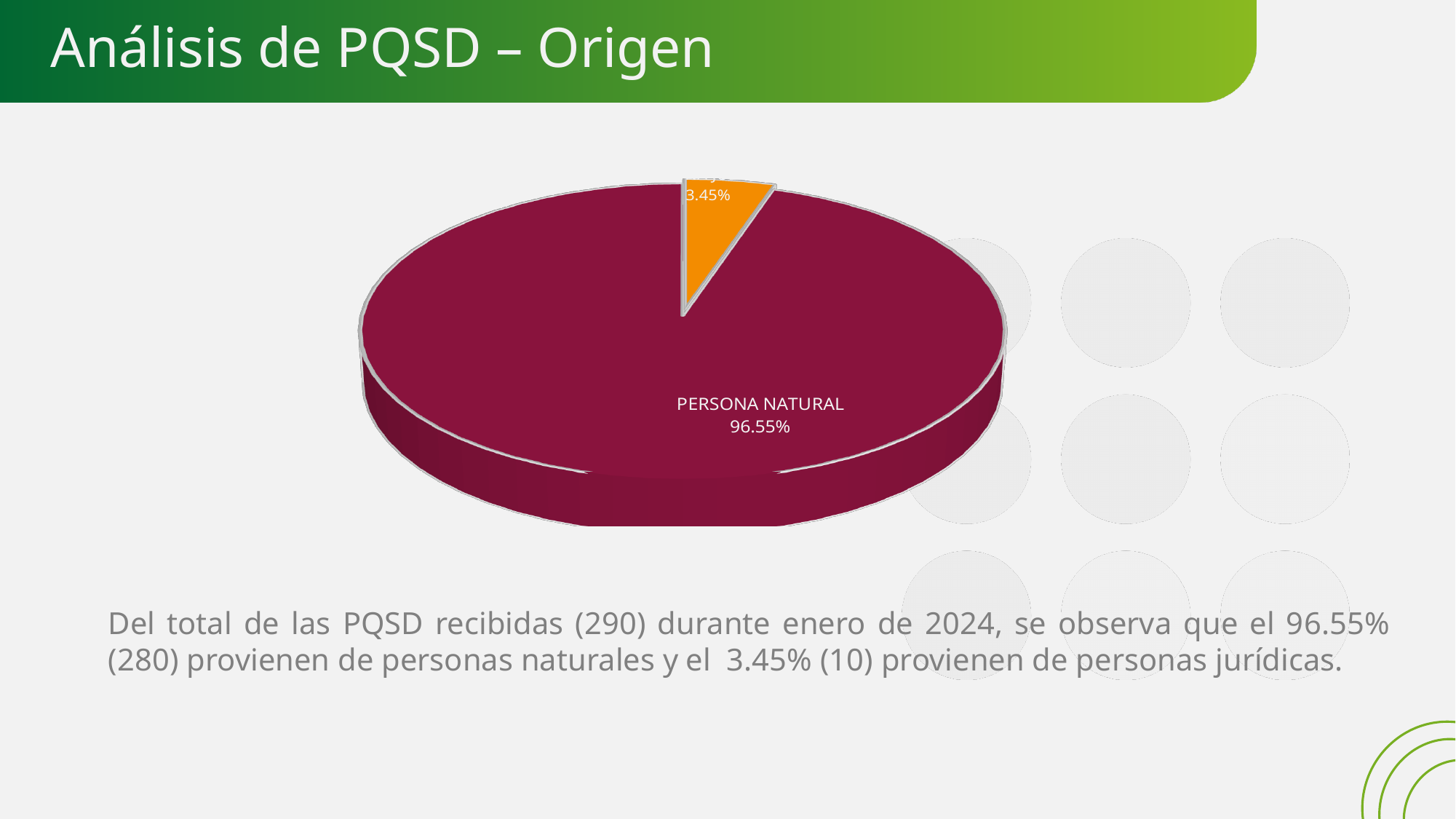
What percentage is shown for the small orange slice of the pie chart? 3.45% Which slice is larger, PERSONA NATURAL or the orange slice? PERSONA NATURAL Is the share for PERSONA NATURAL greater or less than 50%? greater What is the difference in percentage points between the PERSONA NATURAL slice and the orange slice? 93.10 percentage points What colour is the PERSONA NATURAL slice of the pie chart? dark red (maroon) Which slice of the pie chart is the largest? PERSONA NATURAL What is the title of the slide containing the pie chart? Análisis de PQSD – Origen What do the two percentages shown on the pie chart add up to? 100% What percentage is shown for PERSONA NATURAL in the pie chart? 96.55% How many slices does the pie chart have? 2 What share of the pie does the orange slice represent? 3.45% What kind of chart is shown on the slide? pie chart